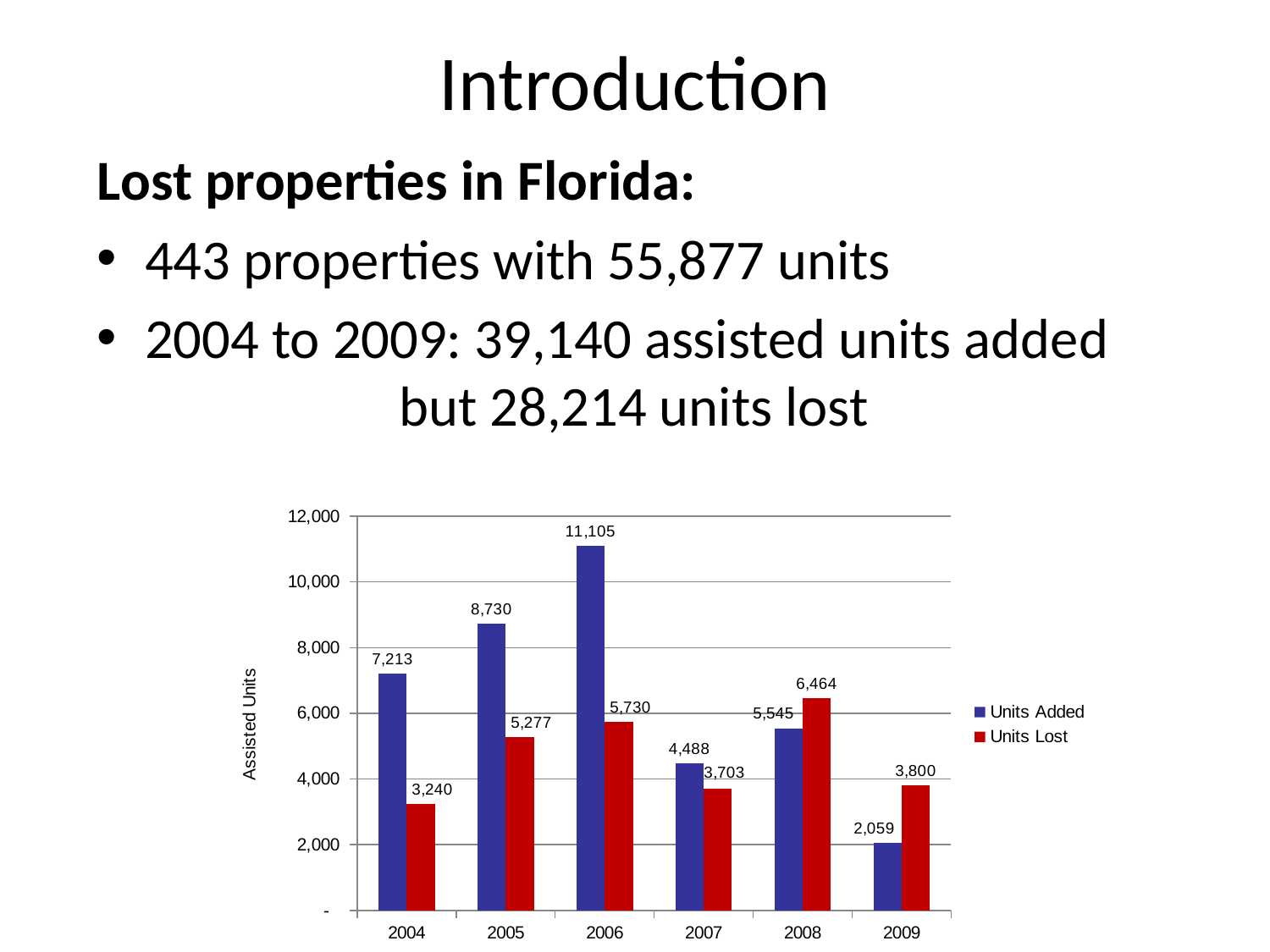
What is the difference between Units Added and Units Lost in 2006? 5,375 What is the value of Units Lost in 2004? 3,240 Which year has the highest value for Units Added? 2006 What is the value of Units Added in 2009? 2,059 How many years are shown on the x axis? 6 Is the value for Units Added in 2005 greater or less than 8,000? greater How many series does the legend list? 2 What is the label of the vertical axis? Assisted Units What is the value of Units Added in 2006? 11,105 What kind of chart is shown on the slide? Bar chart Which year has the lowest value for Units Lost? 2004 In 2008, which is larger: Units Added or Units Lost? Units Lost